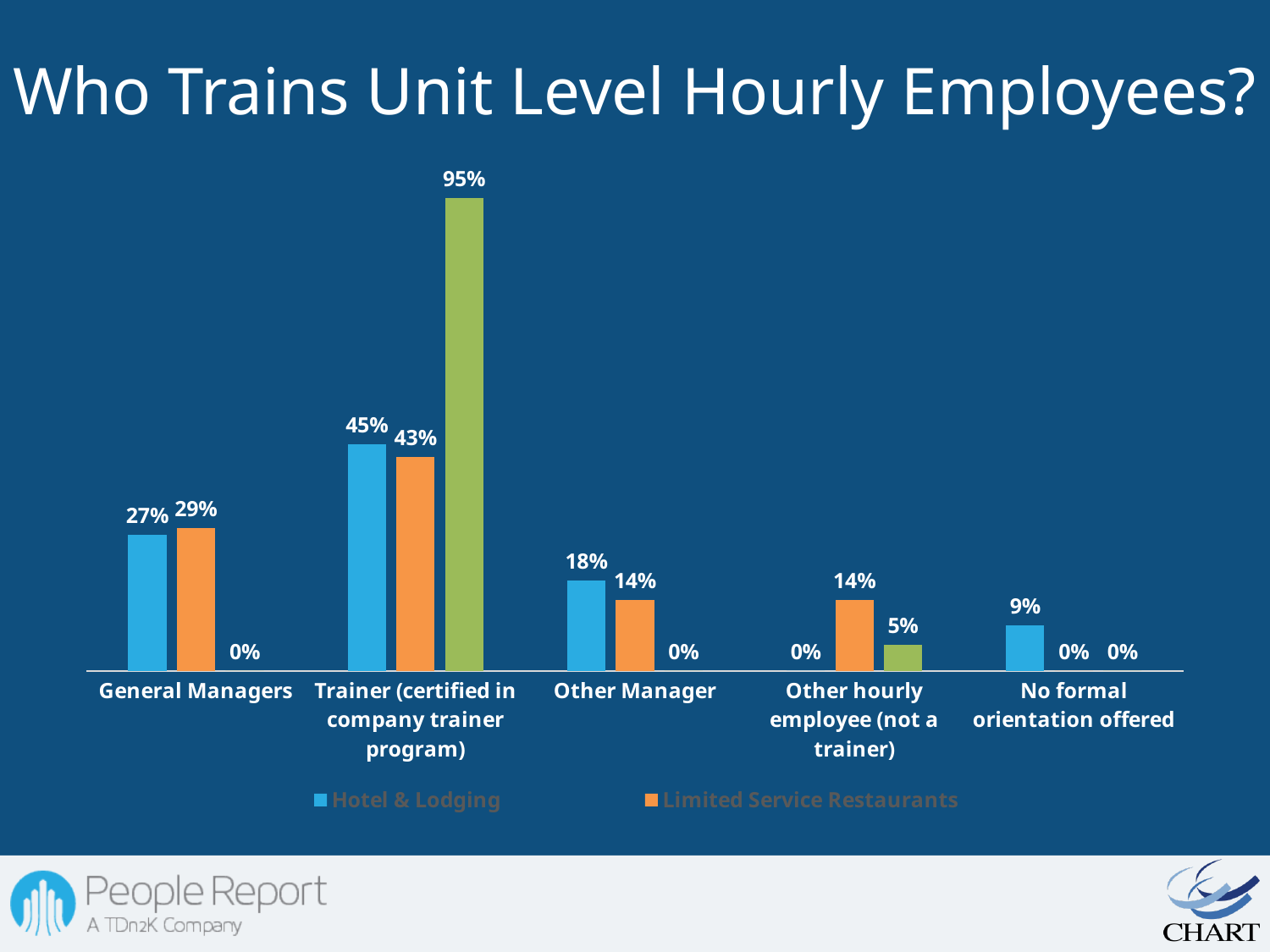
How many series does the legend list? 2 For General Managers, which is larger: Hotel & Lodging or Limited Service Restaurants? Limited Service Restaurants What is the Hotel & Lodging value for General Managers? 27% Which category has the highest Hotel & Lodging value? Trainer (certified in company trainer program) What is the Limited Service Restaurants value for Other hourly employee (not a trainer)? 14% How many categories are shown on the x axis? 5 What is the Hotel & Lodging value for Other Manager? 18% What type of chart is shown on the slide? Bar chart What is the difference between the Hotel & Lodging and Limited Service Restaurants values for Other Manager? 4 percentage points What is the Limited Service Restaurants value for Trainer (certified in company trainer program)? 43% What is the Limited Service Restaurants value for No formal orientation offered? 0% What is the Hotel & Lodging value for No formal orientation offered? 9%